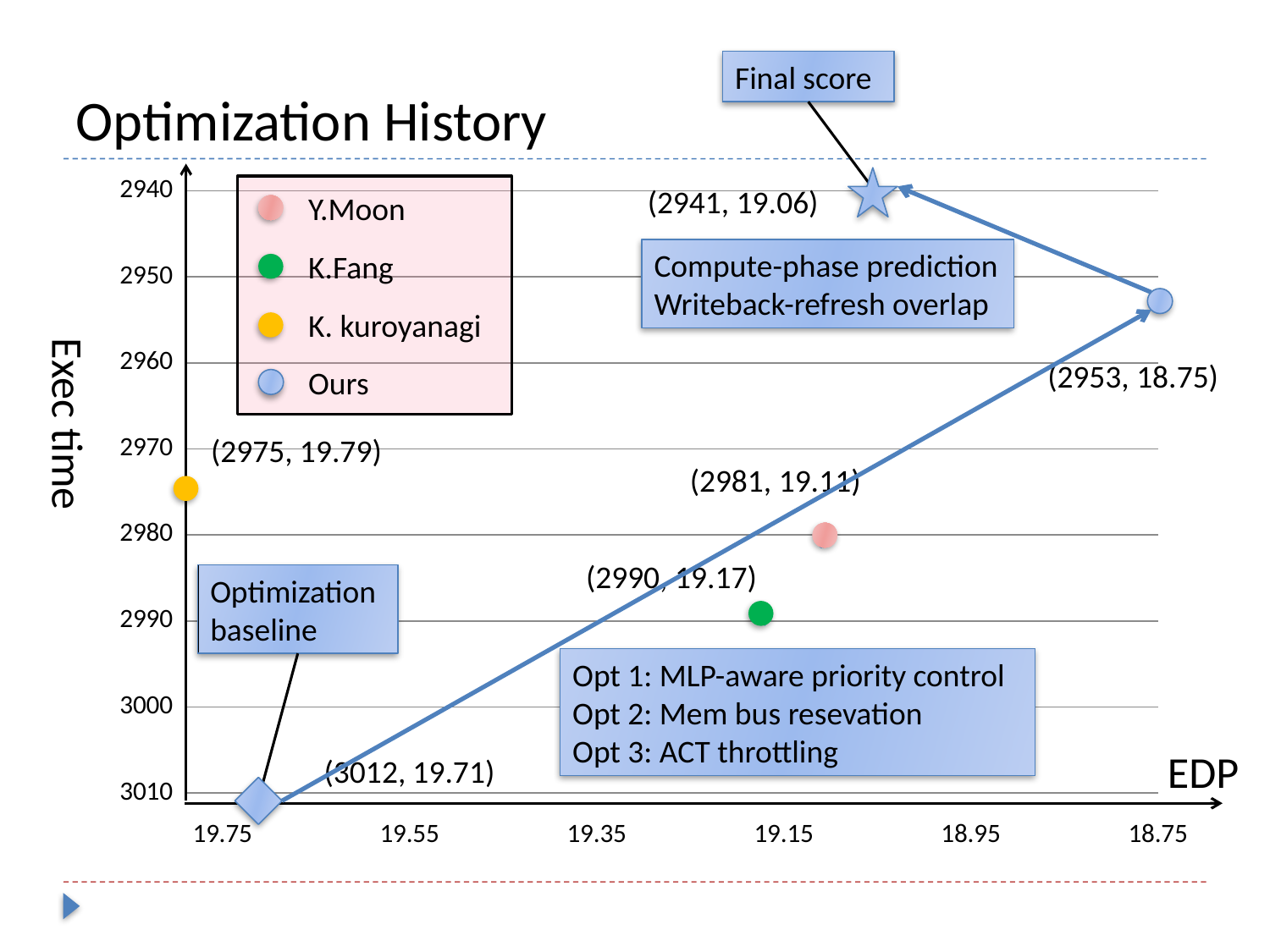
How many series does the legend list? 4 What kind of chart is shown on the slide? scatter chart Which has the higher exec time, the Y.Moon point or the K.Fang point? K.Fang What are the labelled coordinates of the K. kuroyanagi point? (2975, 19.79) What is the difference in exec time between the optimization baseline (3012) and the final score (2941)? 71 What are the labelled coordinates of the point marked 'Optimization baseline'? (3012, 19.71) What are the labelled coordinates of the point marked 'Final score'? (2941, 19.06) What are the labelled coordinates of the Y.Moon point? (2981, 19.11) How many data points are plotted on the chart? 6 What is the label of the vertical axis? Exec time Which labelled point has the lowest exec time? Final score (2941, 19.06) What are the labelled coordinates of the K.Fang point? (2990, 19.17)